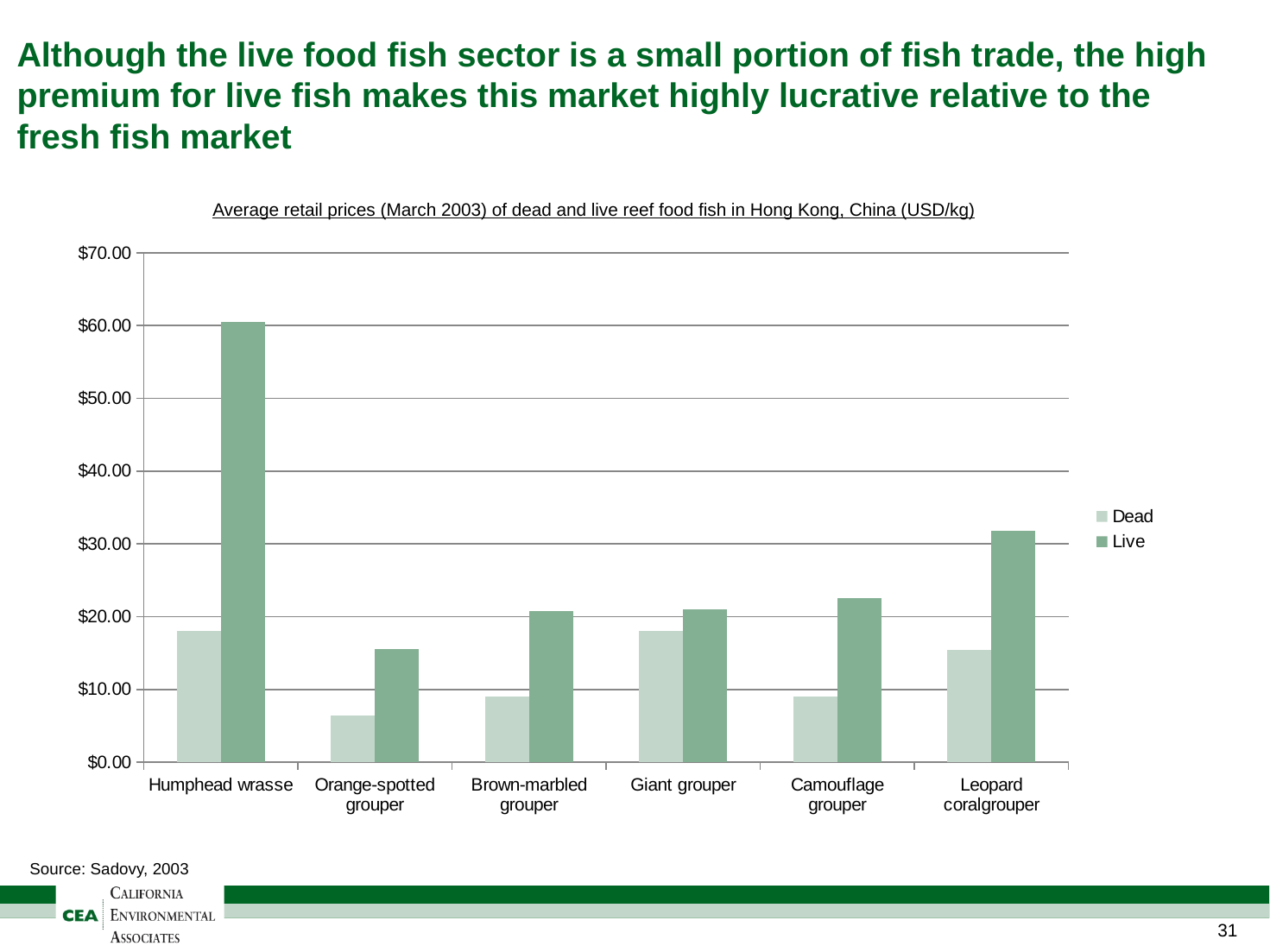
Which fish has the lowest Dead price in the chart? Orange-spotted grouper What kind of chart is shown on the slide? bar chart Is the Dead price for Giant grouper greater or less than $20.00? less How many series does the chart's legend list? 2 Is the Live price for Humphead wrasse greater or less than $50.00? greater What are the two series named in the chart's legend? Dead and Live Which fish has the lowest Live price in the chart? Orange-spotted grouper For Leopard coralgrouper, which is higher: the Dead price or the Live price? Live Which fish has the highest Live price in the chart? Humphead wrasse Is the Dead price for Orange-spotted grouper greater or less than $10.00? less How many fish species are shown on the x axis of the chart? 6